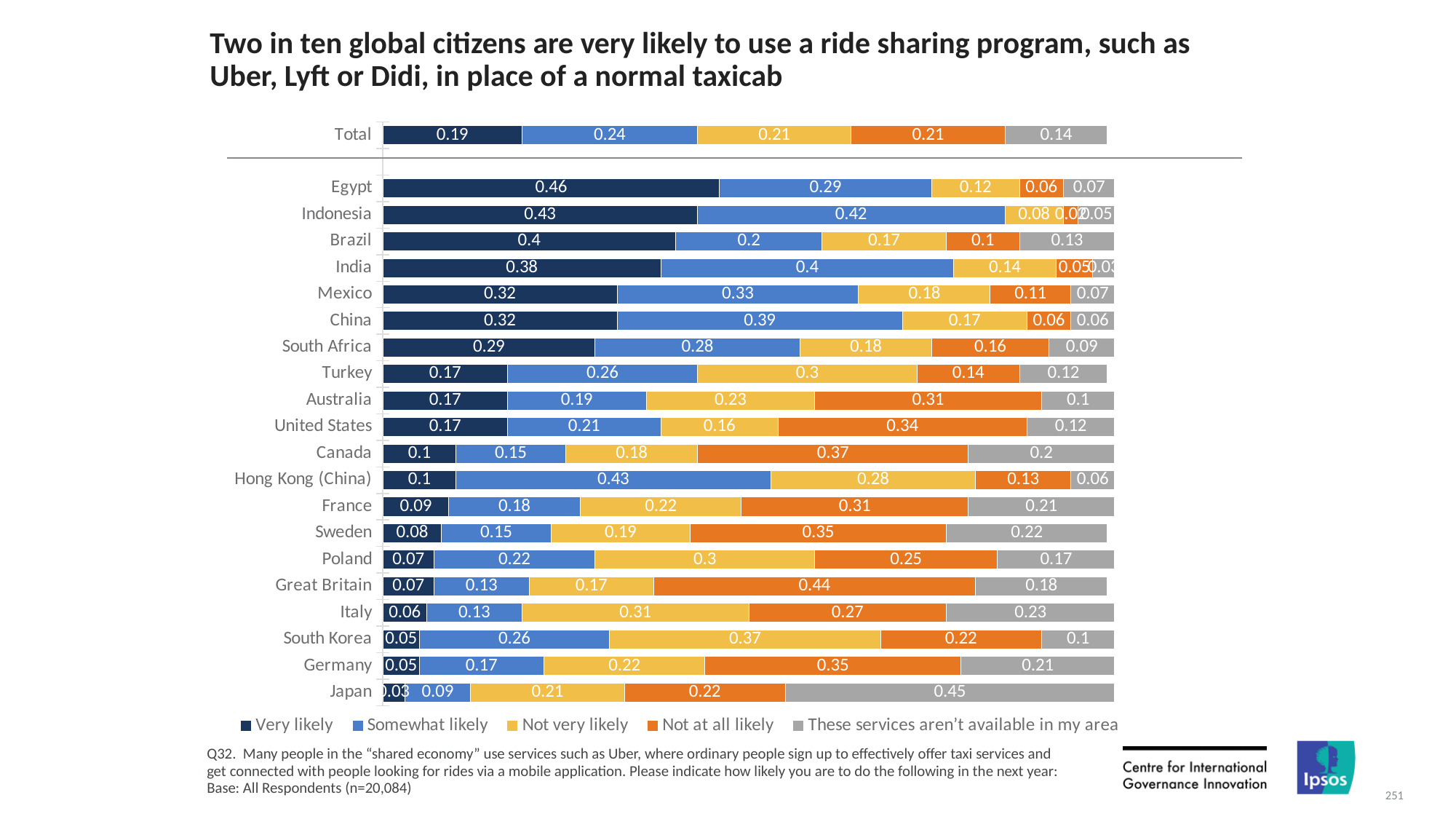
Which country has the highest 'Very likely' value? Egypt What is the 'Very likely' value for Egypt? 0.46 What is the sum of the five segments in the Total bar? 0.99 What is the 'These services aren't available in my area' value for Japan? 0.45 Which country has the lowest 'Very likely' value? Japan How many series does the legend list? 5 What is the 'Not at all likely' value for Great Britain? 0.44 What is the difference between the 'Very likely' values for Brazil and Canada? 0.3 Which is larger: the 'Not at all likely' value for Canada or for Sweden? Canada What is the 'Somewhat likely' value for Hong Kong (China)? 0.43 What kind of chart is shown on the slide? Stacked bar chart How many countries (excluding Total) are listed on the chart? 20